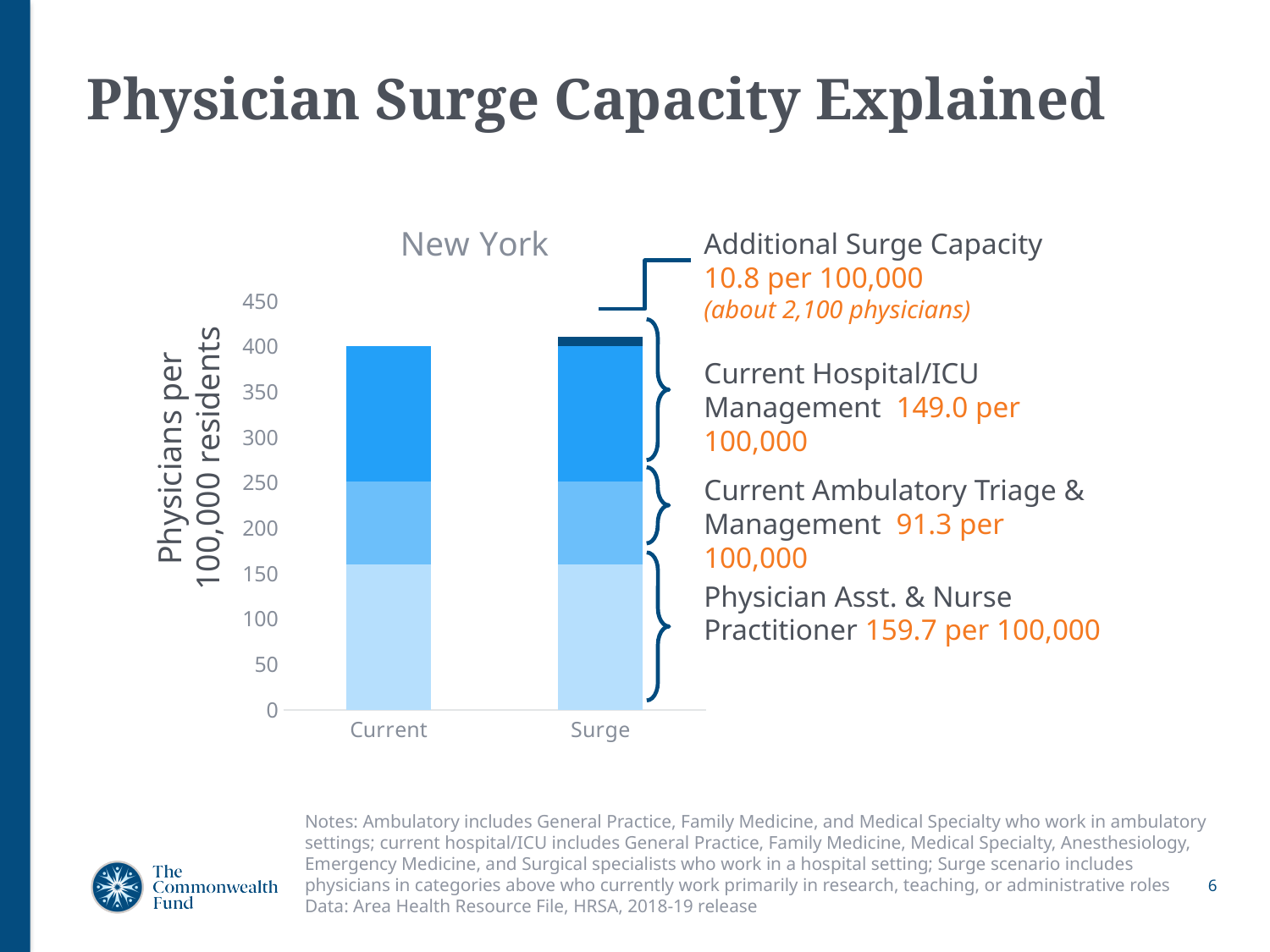
What value is given for Physician Asst. & Nurse Practitioner? 159.7 per 100,000 What value is given for Current Hospital/ICU Management? 149.0 per 100,000 What value is given for Current Ambulatory Triage & Management? 91.3 per 100,000 What is the title of the chart? New York Is the total height of the Current bar greater or less than 350? greater What kind of chart is shown on the slide? Stacked bar chart What is the difference between the Current Hospital/ICU Management value and the Current Ambulatory Triage & Management value? 57.7 per 100,000 How many bars (categories) are plotted on the x axis? 2 What value is given for Additional Surge Capacity in the Surge bar? 10.8 per 100,000 Which segment of the Surge bar is the largest? Physician Asst. & Nurse Practitioner What is the y-axis label of the chart? Physicians per 100,000 residents Which segment of the Surge bar is the smallest? Additional Surge Capacity